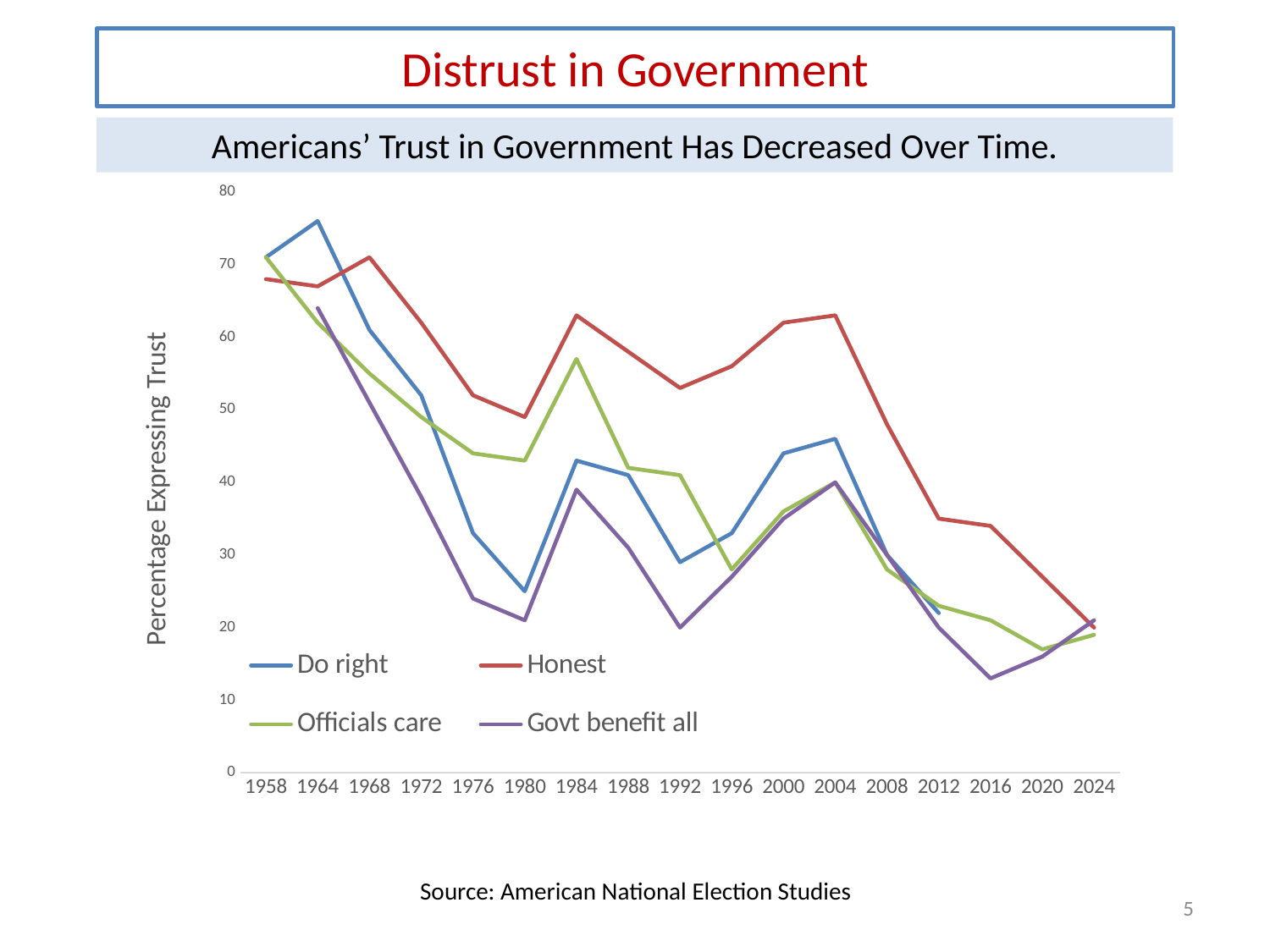
How many years are labelled along the x axis? 17 Which series has the lowest value in 2016? Govt benefit all Does the Honest series rise or fall from 2004 to 2024? fall In 1984, which is larger: the value for Honest or the value for Officials care? Honest Which series has the highest value in 2004? Honest What is the label on the vertical axis? Percentage Expressing Trust What kind of chart is shown on the slide? line chart Is the value for Officials care in 1980 greater or less than 50? less Is the value for Do right in 1964 greater or less than 70? greater How many series does the legend list? 4 Is the value for Govt benefit all in 2016 greater or less than 20? less